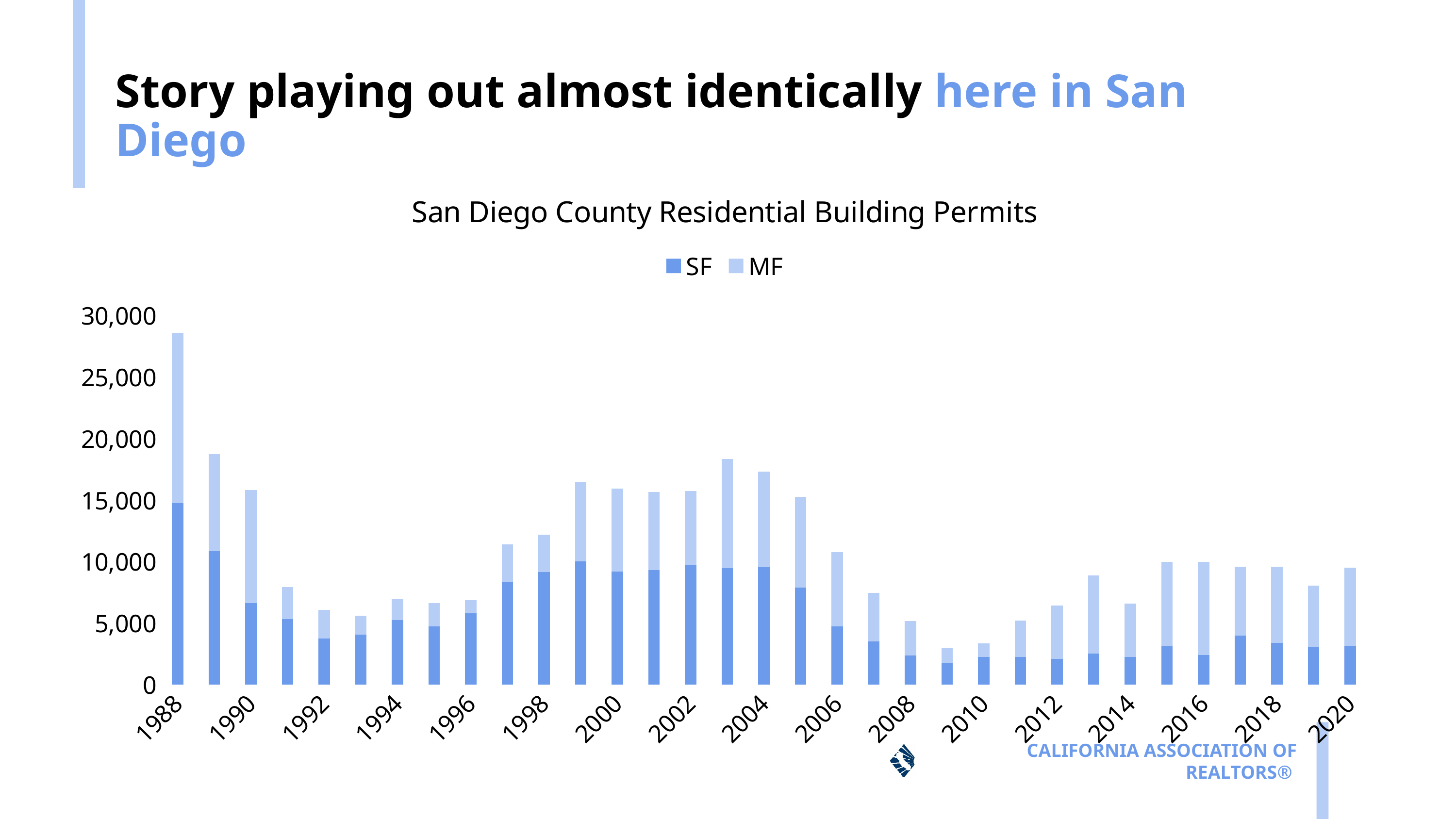
Which year has the larger total of permits, 1989 or 1990? 1989 How many years (bars) are plotted on the chart? 33 Is the total value for 2004 greater or less than 15,000? greater Which year has the highest total number of building permits? 1988 What is the title of the chart? San Diego County Residential Building Permits What are the two series named in the legend? SF and MF What kind of chart is shown on the slide? Stacked bar chart Do total permits rise or fall from 2005 to 2009? Fall How many series does the legend list? 2 Is the total value for 1988 greater or less than 25,000? greater Which year has the lowest total number of building permits? 2009 Is the total value for 2009 greater or less than 5,000? less